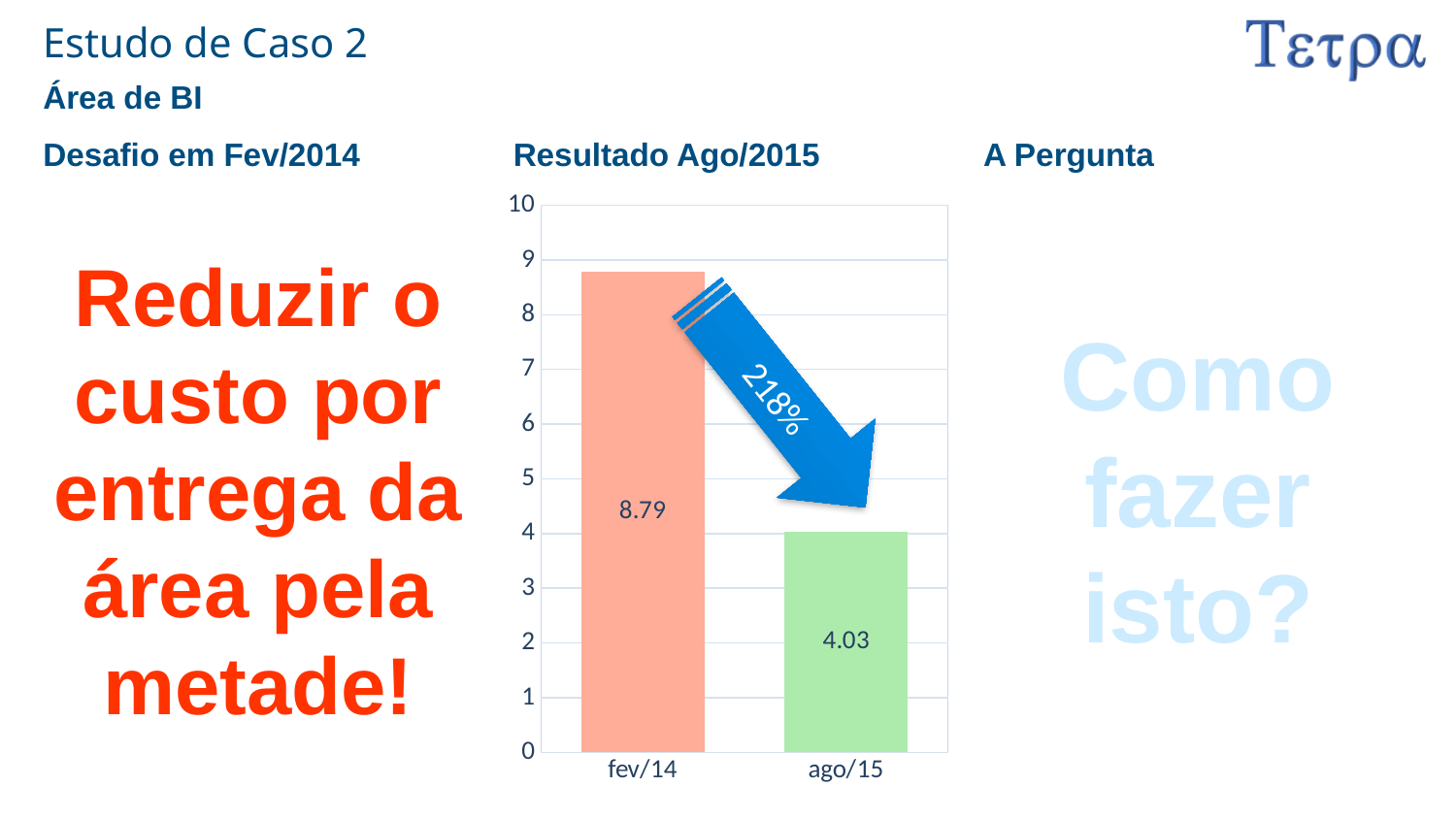
Is the value for ago/15 greater or less than 5? less What is the difference between the values for fev/14 and ago/15? 4.76 What kind of chart is shown? bar chart Is the value for fev/14 greater or less than 8? greater How many categories are shown on the x axis? 2 Do the values rise or fall from fev/14 to ago/15? fall What is the value for fev/14? 8.79 What is the value for ago/15? 4.03 Which is larger, the value for fev/14 or the value for ago/15? fev/14 Which category has the lowest value? ago/15 What percentage is written on the arrow overlaid on the chart? 218% Which category has the highest value? fev/14